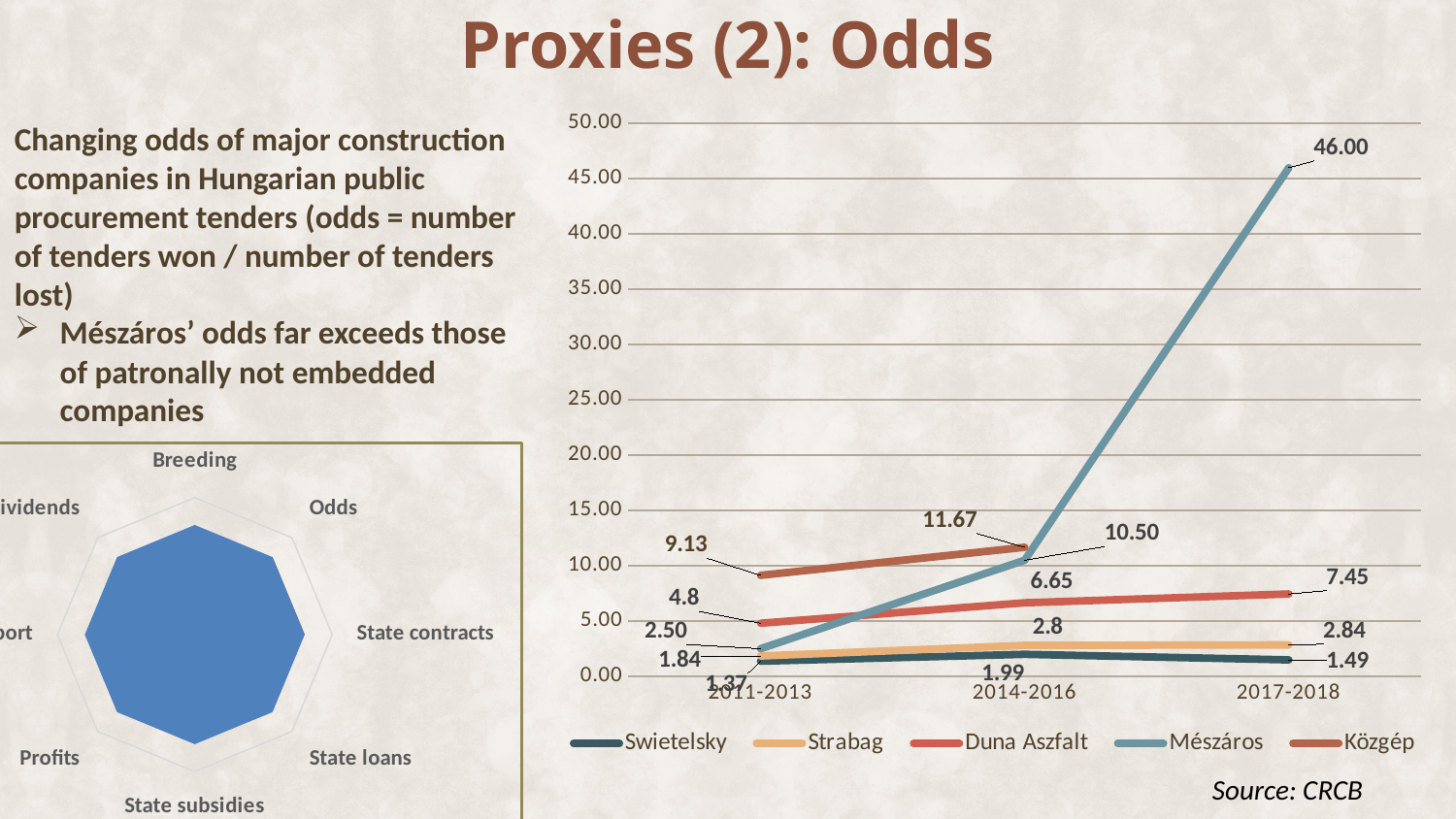
In the line chart on the right, is the value for Mészáros in 2017-2018 greater or less than 40.00? greater In the line chart on the right, which is larger in 2014-2016: the value for Közgép or the value for Mészáros? Közgép In the line chart on the right, which company has the highest value in 2017-2018? Mészáros How many series does the legend of the line chart on the right list? 5 In the line chart on the right, what is the value for Swietelsky in 2017-2018? 1.49 In the line chart on the right, which company has the lowest value in 2011-2013? Swietelsky In the line chart on the right, what is the value for Közgép in 2014-2016? 11.67 In the line chart on the right, what is the value for Mészáros in 2017-2018? 46.00 In the line chart on the right, does the value for Mészáros rise or fall from 2011-2013 to 2017-2018? rise What kind of chart is shown on the right side of the slide? line chart In the line chart on the right, what is the value for Duna Aszfalt in 2011-2013? 4.8 In the line chart on the right, what is the difference between Mészáros' value in 2017-2018 and its value in 2014-2016? 35.50